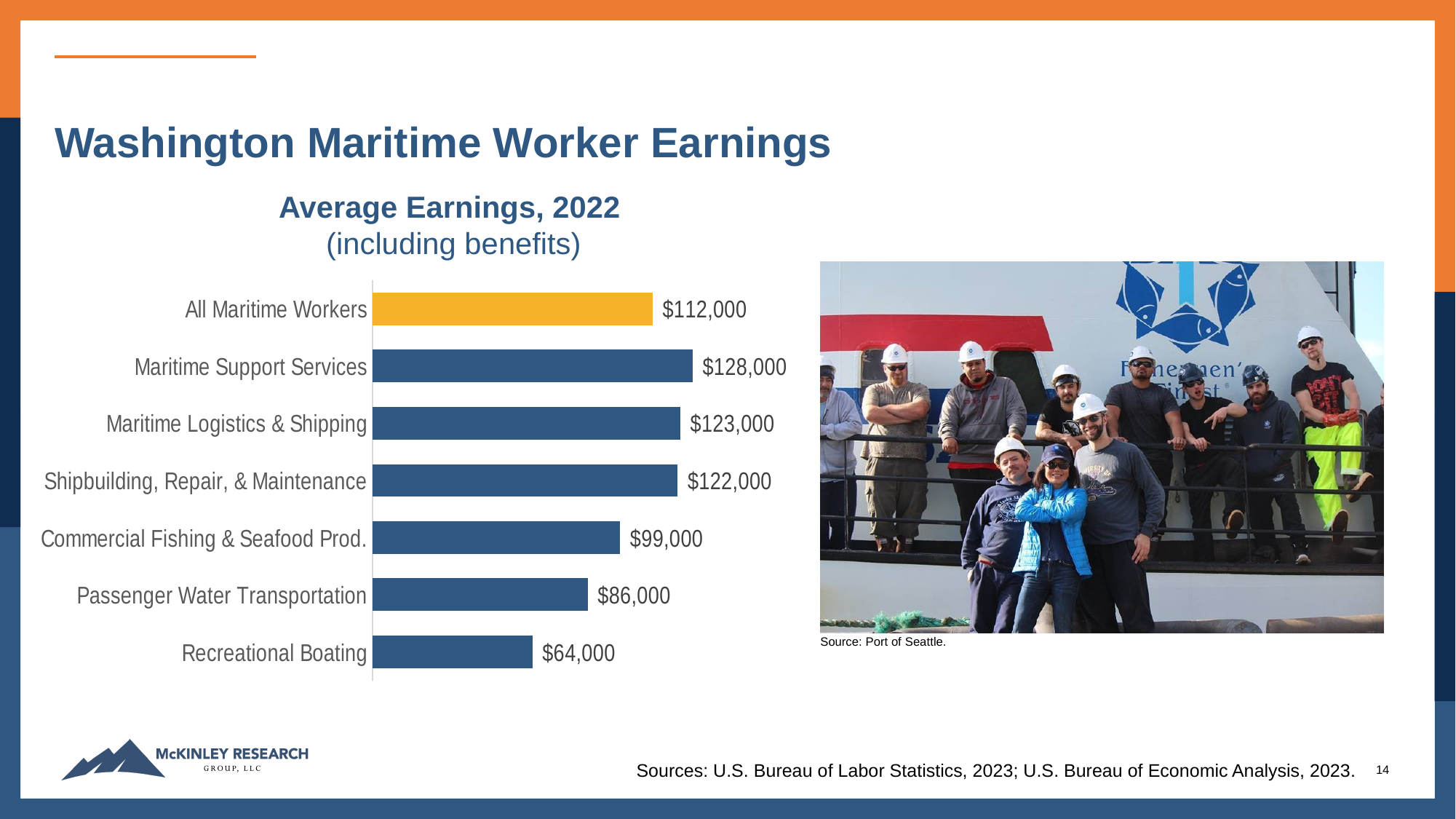
What is the difference in average earnings between Maritime Support Services and Recreational Boating? $64,000 What are the average earnings for Passenger Water Transportation? $86,000 How many categories are shown in the chart? 7 What are the average earnings for Maritime Support Services? $128,000 What are the average earnings for Recreational Boating? $64,000 What is the difference in average earnings between Maritime Logistics & Shipping and Commercial Fishing & Seafood Prod.? $24,000 Which category has the lowest average earnings? Recreational Boating What are the average earnings for All Maritime Workers? $112,000 Which category has the highest average earnings? Maritime Support Services What kind of chart is shown on the slide? Bar chart Which bar in the chart is coloured differently (orange) from the others? All Maritime Workers Which has higher average earnings, Commercial Fishing & Seafood Prod. or Passenger Water Transportation? Commercial Fishing & Seafood Prod.